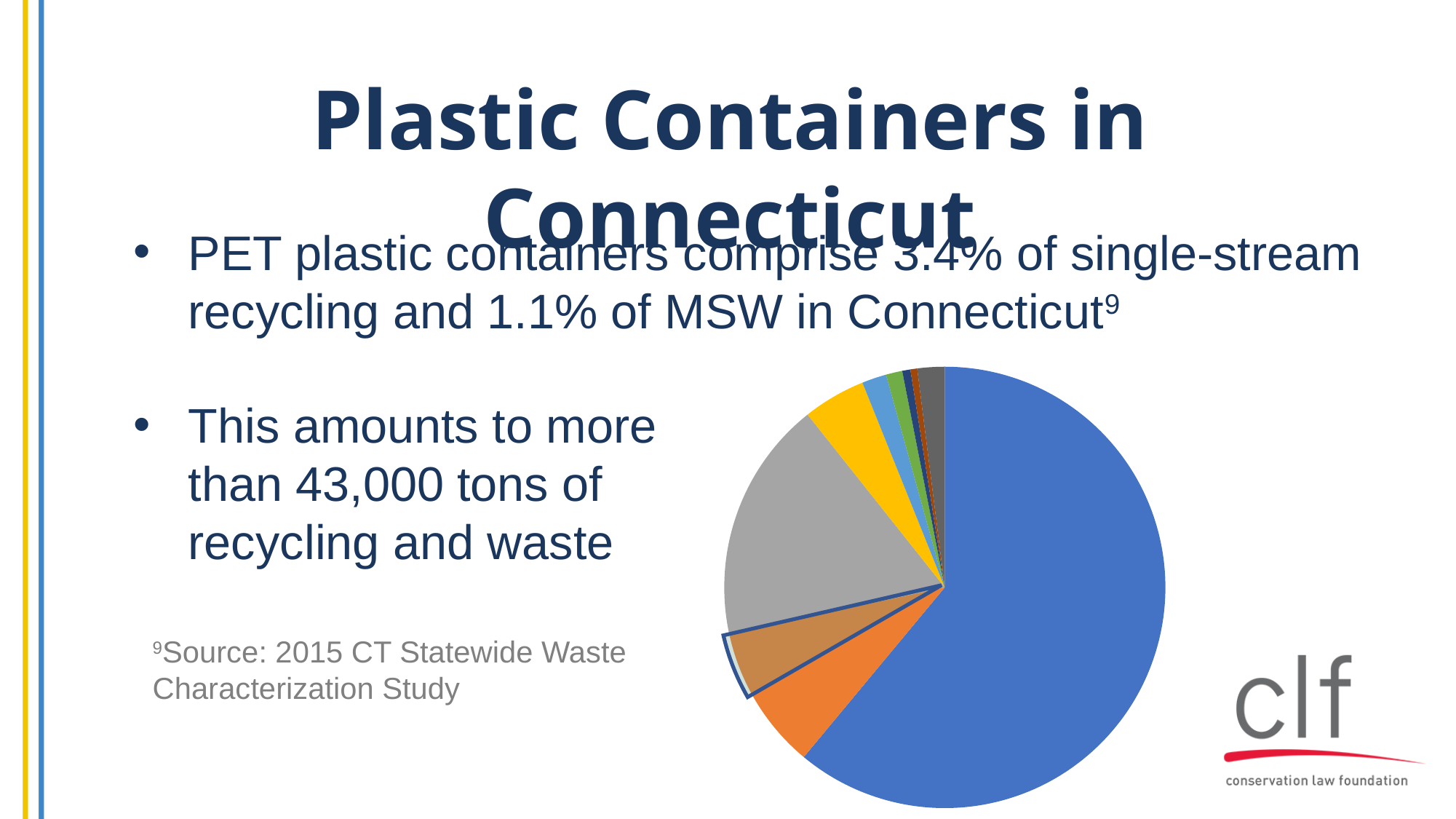
What colour is the largest slice of the pie chart? blue Does the largest slice of the pie chart cover more or less than half of the pie? more What kind of chart is shown on the slide? pie chart Which slice of the pie chart is pulled out (exploded) from the rest of the pie? the tan/brown slice